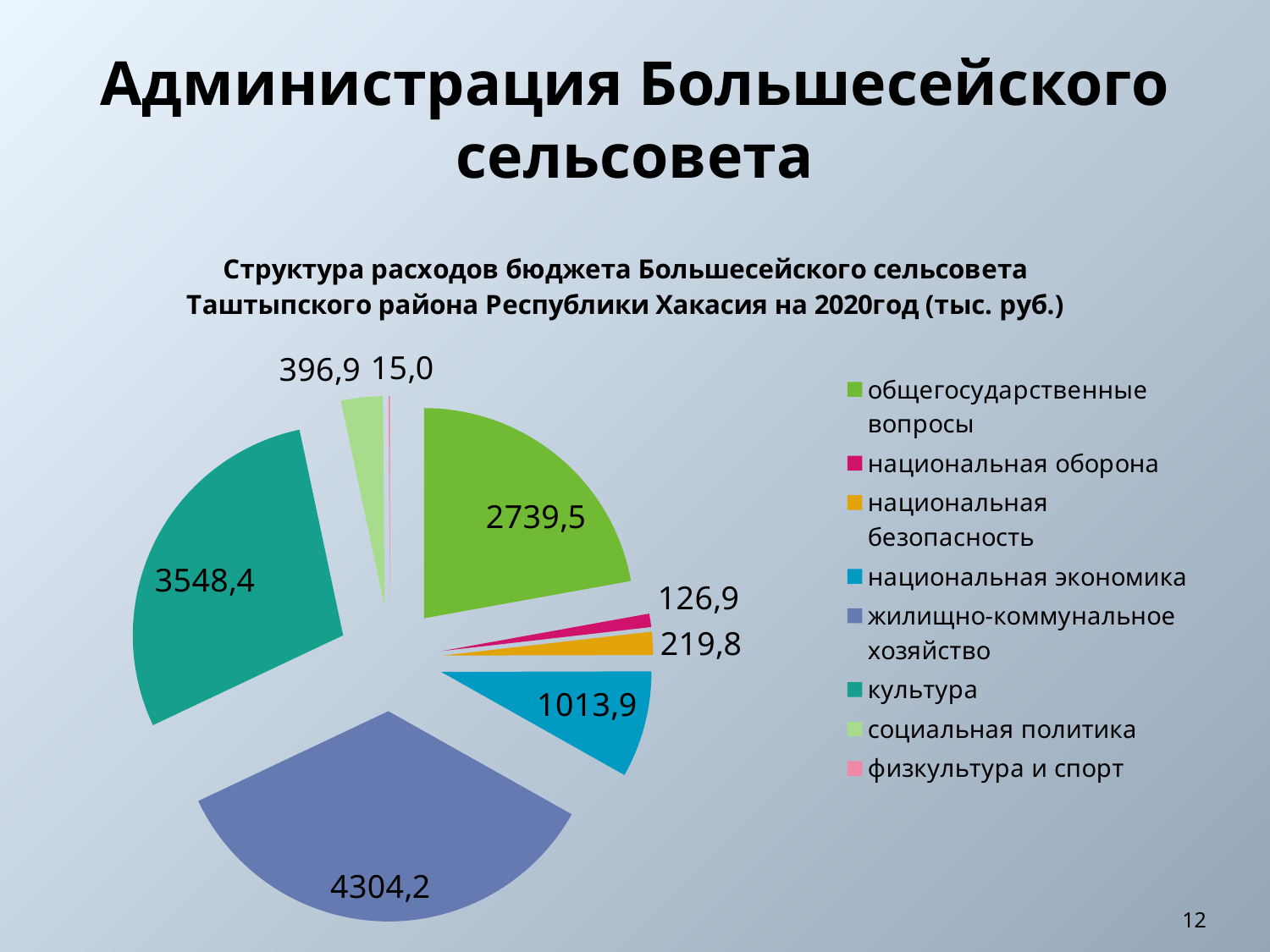
Which is larger, культура or общегосударственные вопросы? культура What is the value for общегосударственные вопросы? 2739,5 What unit is stated in the chart title? тыс. руб. How many categories does the legend list? 8 Which category has the largest value? жилищно-коммунальное хозяйство What is the value for физкультура и спорт? 15,0 What is the difference between национальная безопасность and национальная оборона? 92,9 What is the difference between жилищно-коммунальное хозяйство and культура? 755,8 Which category has the smallest value? физкультура и спорт What is the value for жилищно-коммунальное хозяйство? 4304,2 What type of chart is shown on the slide? pie chart What is the value for национальная оборона? 126,9